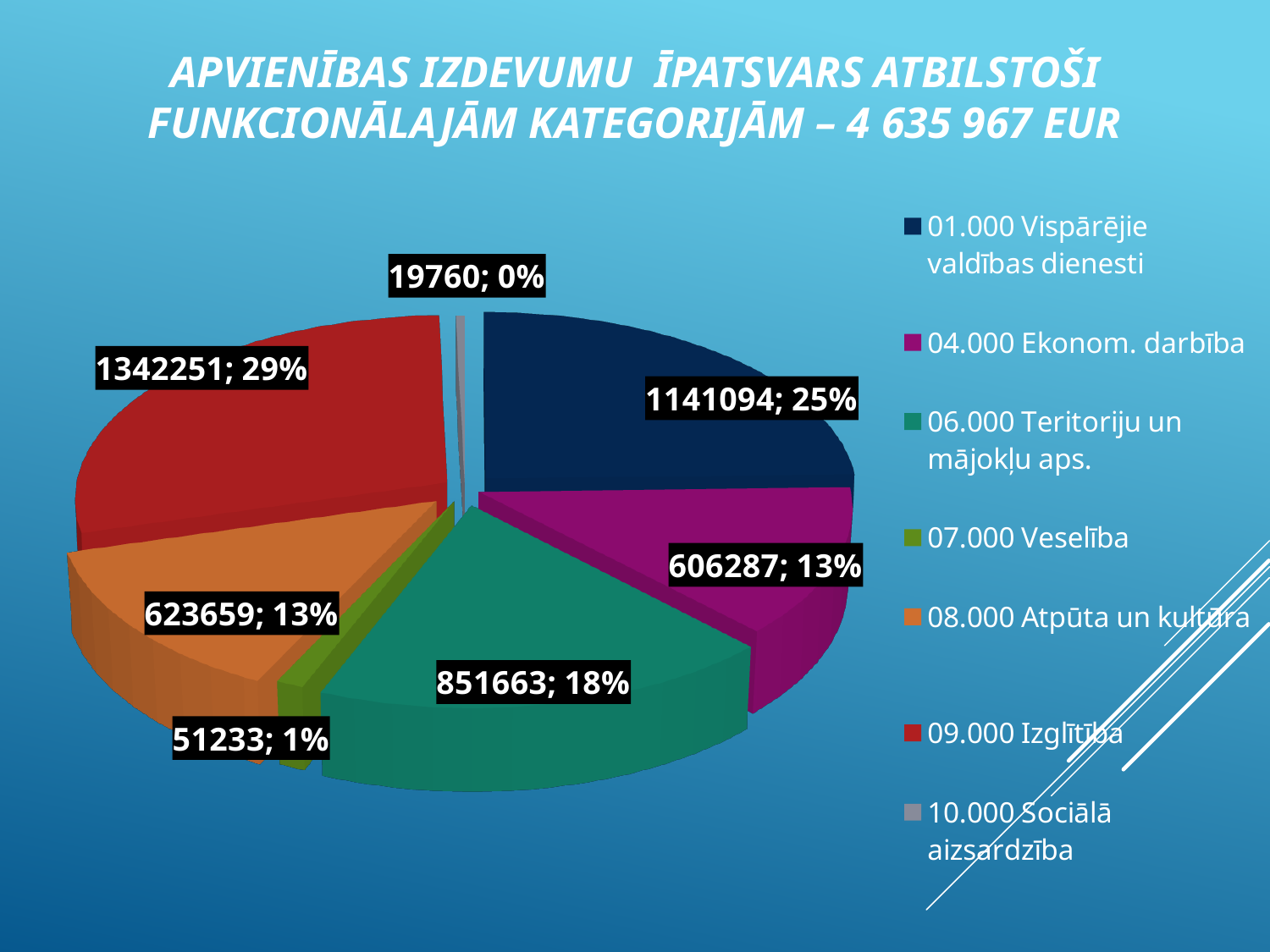
Which category has the smallest slice of the pie? 10.000 Sociālā aizsardzība Which category has the largest slice of the pie? 09.000 Izglītība What value is shown for 06.000 Teritoriju un mājokļu aps.? 851663 What kind of chart is shown on the slide? Pie chart What total amount in EUR is stated in the slide title? 4 635 967 EUR Which is larger, the value for 08.000 Atpūta un kultūra or the value for 04.000 Ekonom. darbība? 08.000 Atpūta un kultūra What value is shown for 09.000 Izglītība? 1342251 What is the difference between the values for 09.000 Izglītība and 01.000 Vispārējie valdības dienesti? 201157 What percentage share is shown for 04.000 Ekonom. darbība? 13% What value is shown for 07.000 Veselība? 51233 How many categories does the legend list? 7 What percentage share is shown for 01.000 Vispārējie valdības dienesti? 25%